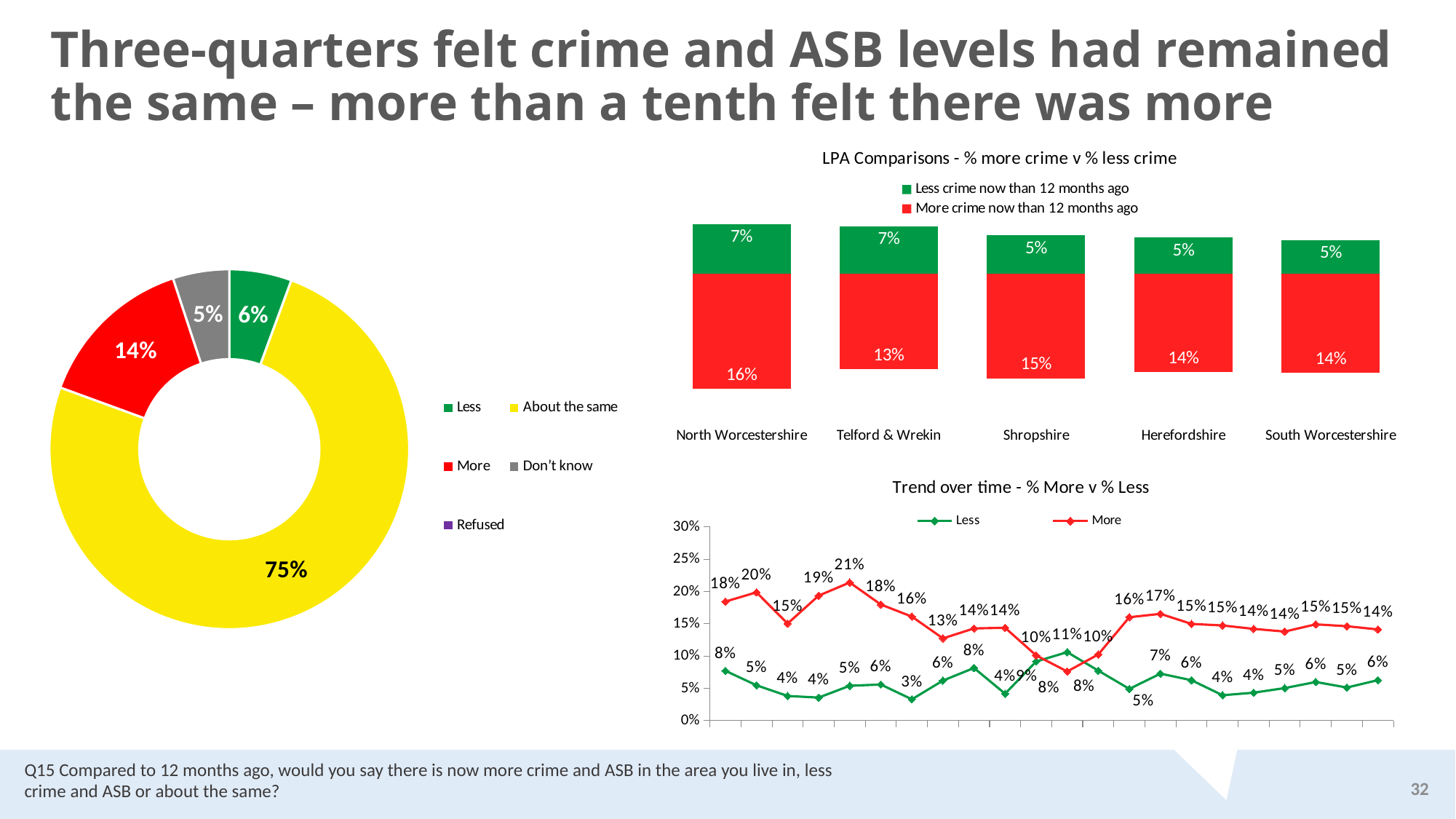
On the LPA Comparisons chart, what is the total of the stacked bar for Telford & Wrekin? 20% On the donut chart on the left, what percentage said there was more crime? 14% On the LPA Comparisons chart, how many areas are shown? 5 On the Trend over time chart, what is the highest value reached by the More line? 21% On the donut chart on the left, how many entries does the legend list? 5 On the LPA Comparisons chart, what is the 'More crime now than 12 months ago' value for North Worcestershire? 16% On the LPA Comparisons chart, what is the 'Less crime now than 12 months ago' value for Shropshire? 5% On the LPA Comparisons chart, what is the difference between the 'More crime' and 'Less crime' values for Herefordshire? 9% On the LPA Comparisons chart, which area has the highest 'More crime now than 12 months ago' value? North Worcestershire On the donut chart on the left, which category has the smallest labelled share? Don't know What type of chart is the Trend over time chart? Line chart On the donut chart on the left, what percentage said crime and ASB levels were about the same? 75%